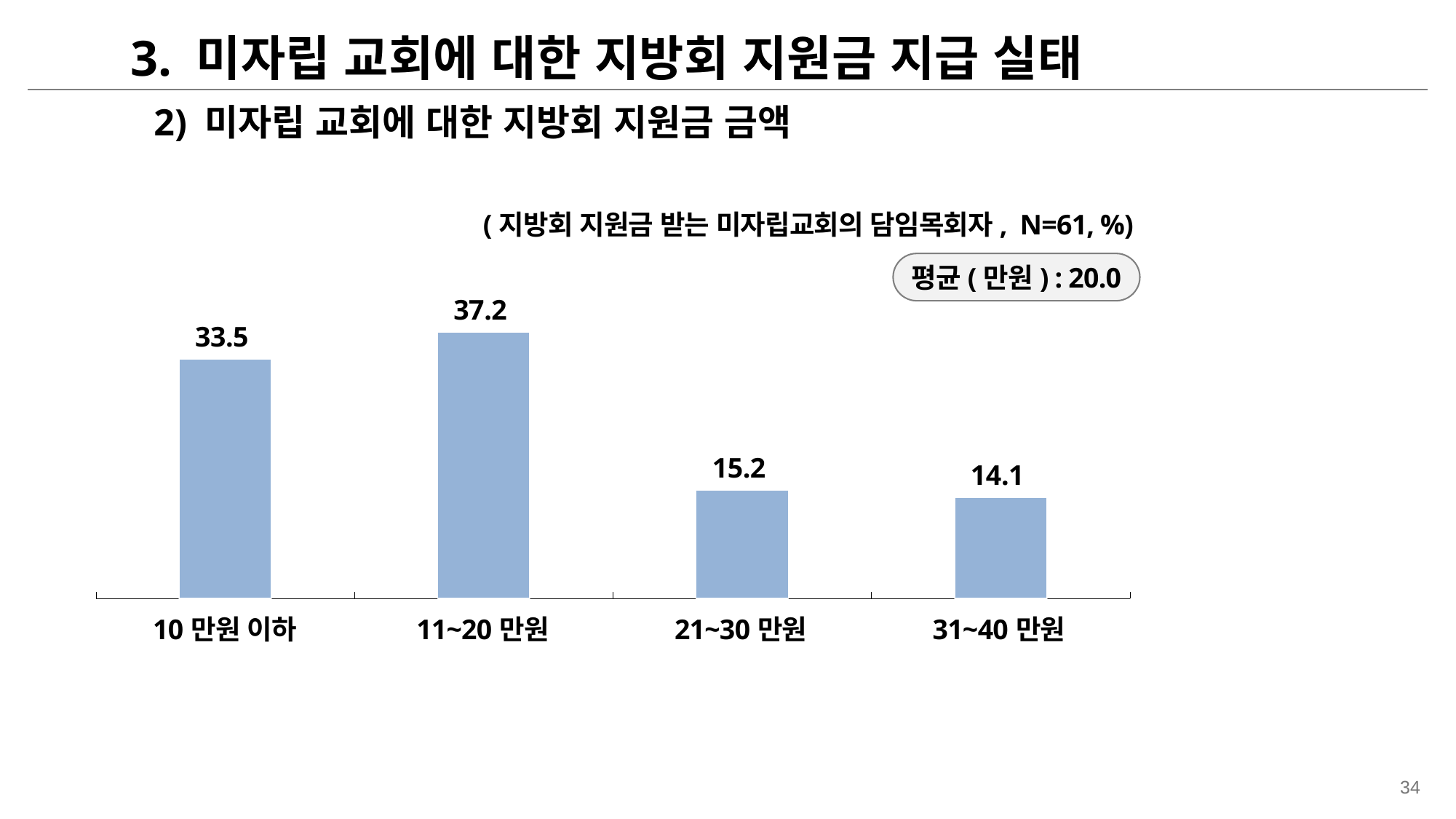
What kind of chart is shown on the slide? Bar chart What is the difference between the values for 21~30 만원 and 31~40 만원? 1.1 What is the difference between the values for 11~20 만원 and 10 만원 이하? 3.7 Which is larger, the value for 10 만원 이하 or the value for 21~30 만원? 10 만원 이하 What is the value for 10 만원 이하? 33.5 Which category has the highest value? 11~20 만원 What is the value for 11~20 만원? 37.2 Which category has the lowest value? 31~40 만원 What is the value for 21~30 만원? 15.2 What is the value for 31~40 만원? 14.1 How many categories are shown on the x axis? 4 What average (평균) value in 만원 is shown in the box on the chart? 20.0